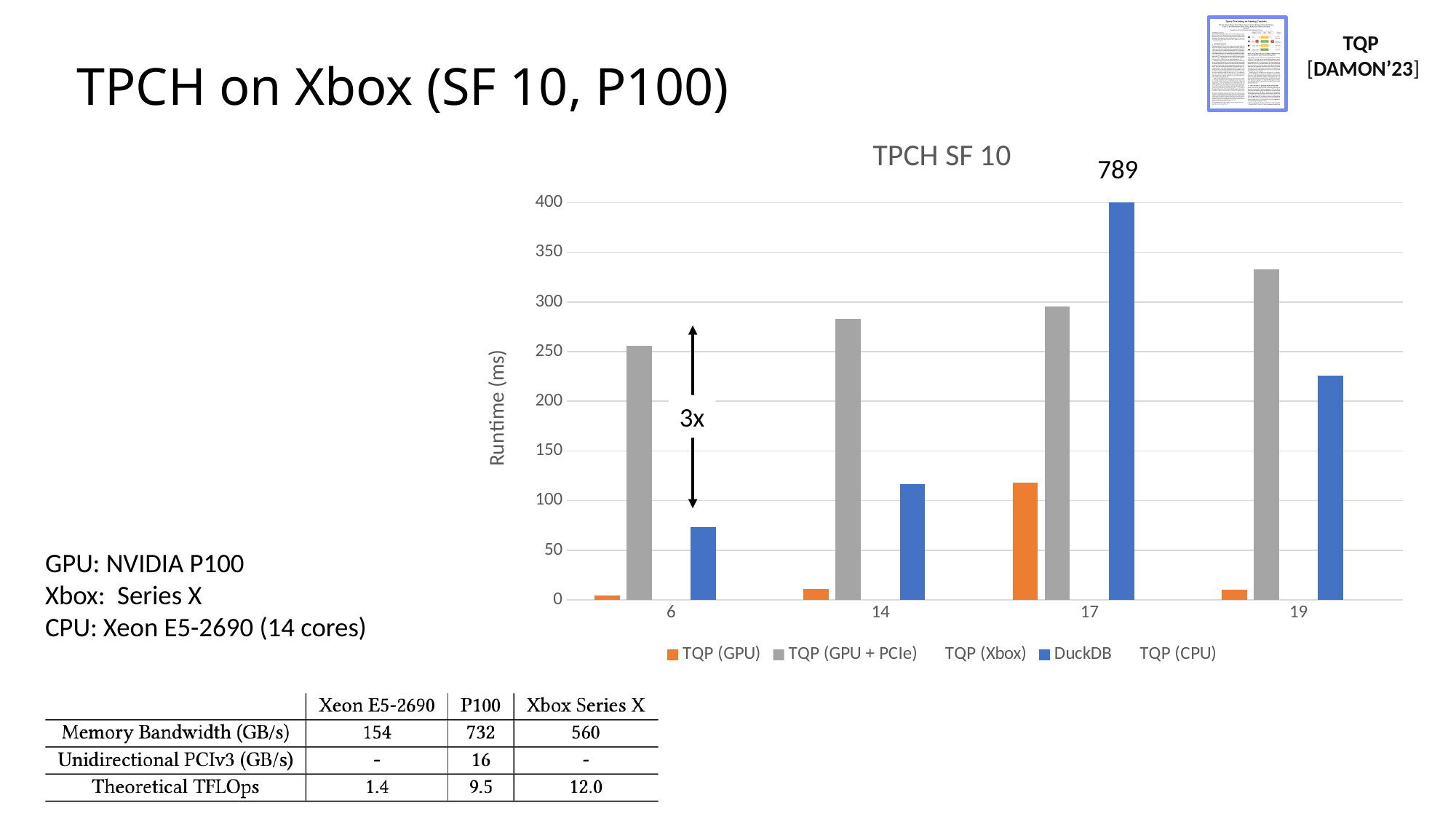
For which query is the TQP (GPU) runtime highest? 17 What is the DuckDB runtime for query 17? 789 What kind of chart is shown on the slide? bar chart Is the DuckDB value for query 6 greater or less than 100? less How many series does the legend list? 5 What is the title of the chart? TPCH SF 10 What is the label of the vertical axis? Runtime (ms) Is the TQP (GPU + PCIe) value for query 19 greater or less than 300? greater How many query categories are shown on the x axis? 4 For which query is the DuckDB runtime highest? 17 For query 19, which is larger: DuckDB or TQP (GPU + PCIe)? TQP (GPU + PCIe) For query 14, which is larger: TQP (GPU + PCIe) or DuckDB? TQP (GPU + PCIe)